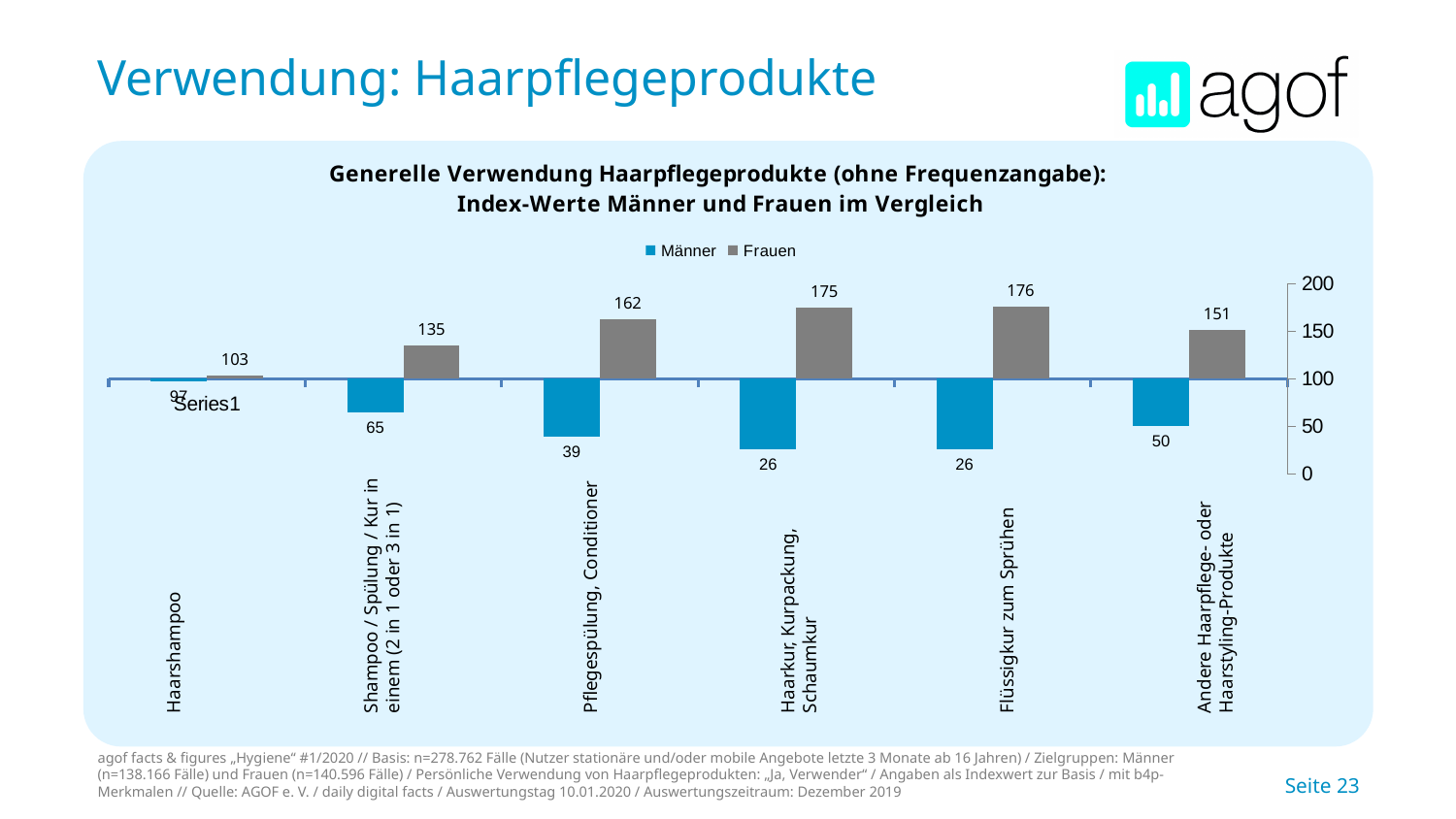
Is the Frauen value for Pflegespülung, Conditioner greater or less than 150? greater What is the difference between the Frauen and Männer index values for Haarkur, Kurpackung, Schaumkur? 149 What is the Männer index value for Andere Haarpflege- oder Haarstyling-Produkte? 50 What is the Frauen index value for Flüssigkur zum Sprühen? 176 How many series does the legend list? 2 What is the Frauen index value for Shampoo / Spülung / Kur in einem (2 in 1 oder 3 in 1)? 135 Which category has the highest Frauen index value? Flüssigkur zum Sprühen Which is larger: the Männer value for Shampoo / Spülung / Kur in einem or the Männer value for Andere Haarpflege- oder Haarstyling-Produkte? Shampoo / Spülung / Kur in einem What kind of chart is shown on the slide? Bar chart What is the Männer index value for Pflegespülung, Conditioner? 39 How many product categories are shown on the x axis? 6 Which category has the lowest Frauen index value? Haarshampoo